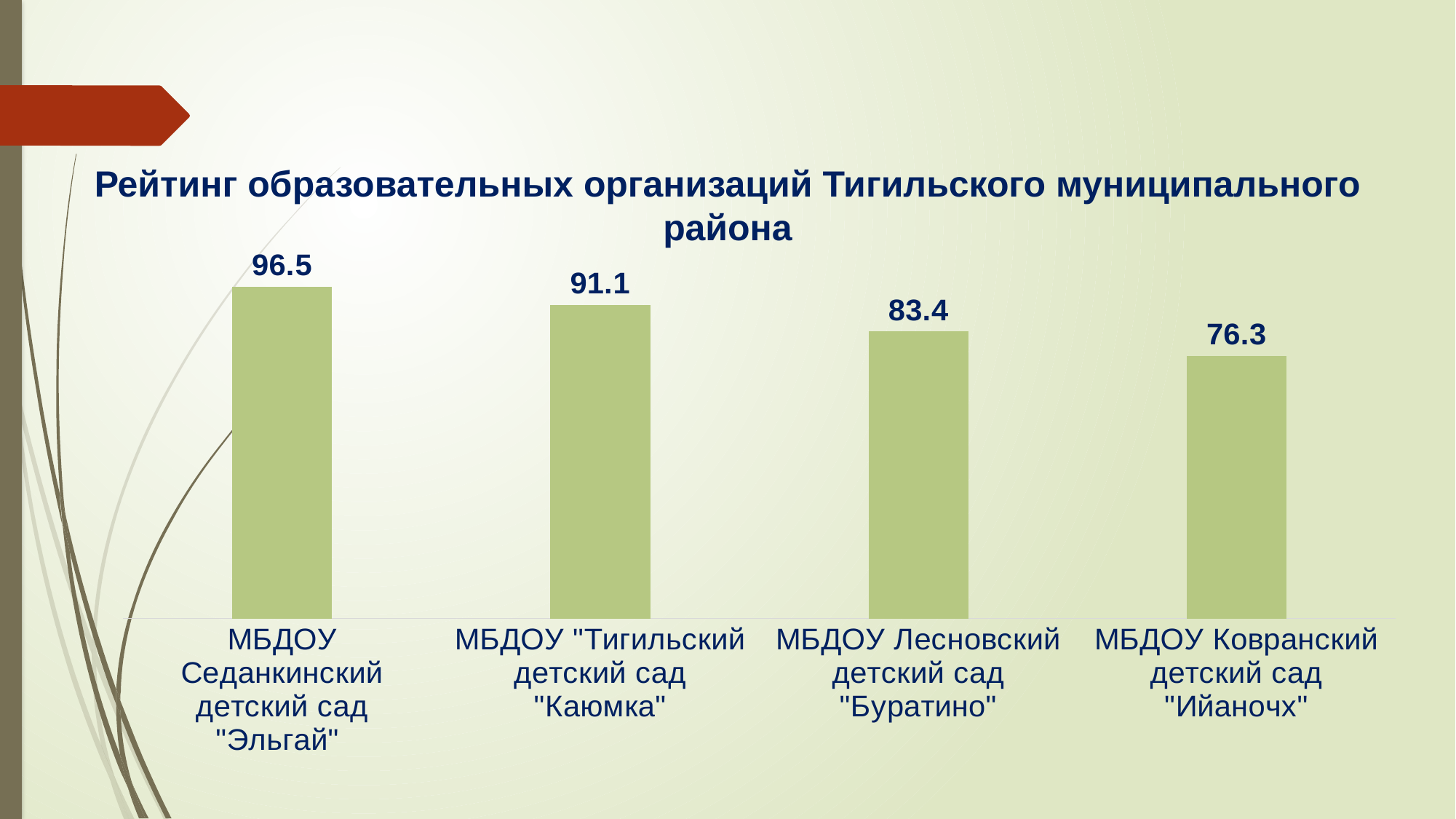
What is the value for МБДОУ Ковранский детский сад "Ийаночх"? 76.3 Which has a larger value, "Каюмка" or "Буратино"? "Каюмка" What is the difference between the values for "Эльгай" and "Ийаночх"? 20.2 Do the values rise or fall from left to right across the chart? Fall What kind of chart is shown on the slide? Bar chart What is the value for МБДОУ "Тигильский детский сад "Каюмка"? 91.1 Which organisation has the highest value? МБДОУ Седанкинский детский сад "Эльгай" What is the difference between the values for "Каюмка" and "Буратино"? 7.7 Which organisation has the lowest value? МБДОУ Ковранский детский сад "Ийаночх" What is the value for МБДОУ Седанкинский детский сад "Эльгай"? 96.5 What is the value for МБДОУ Лесновский детский сад "Буратино"? 83.4 How many organisations are shown in the chart? 4